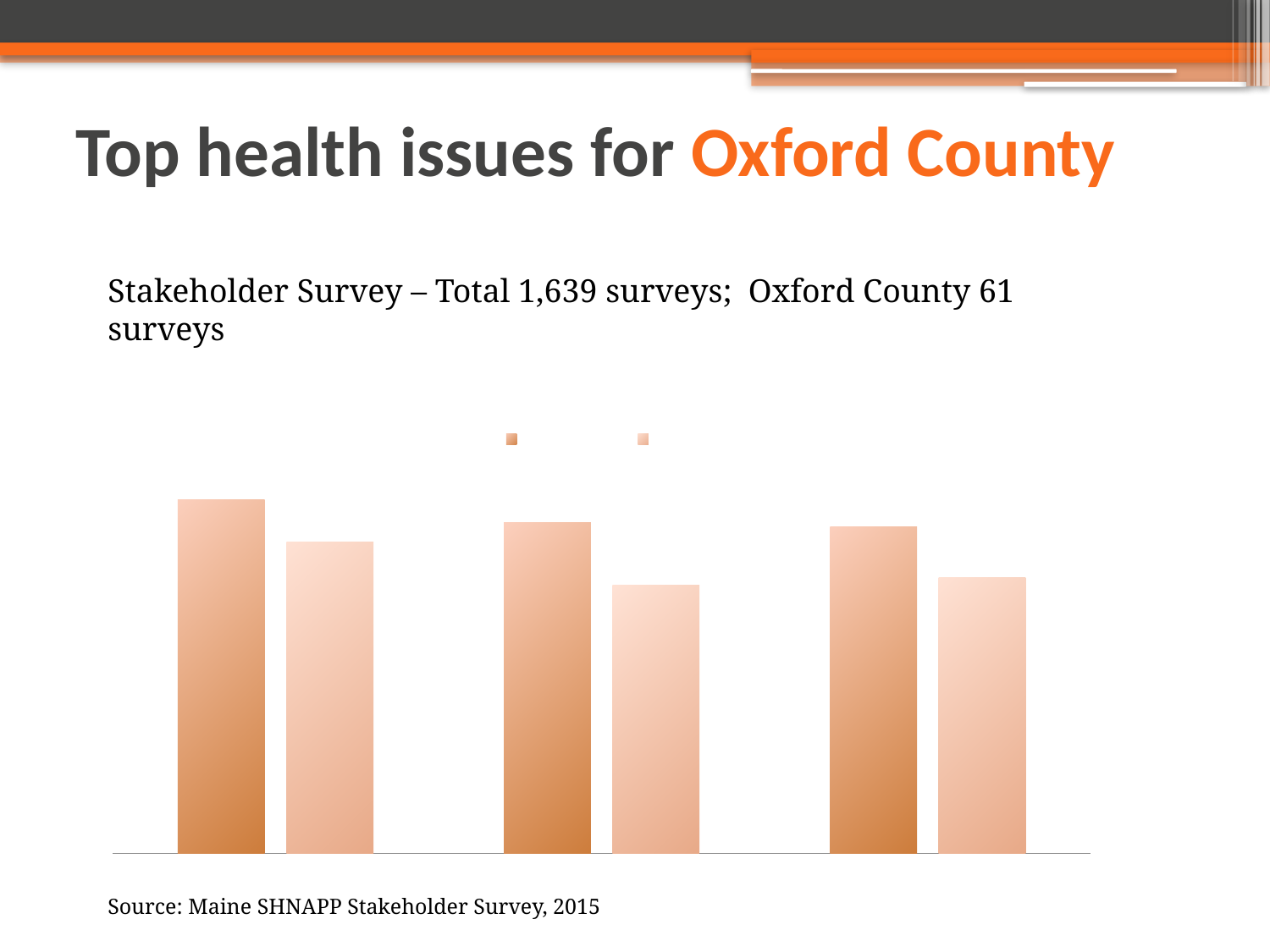
How many groups of bars does the chart show? 3 Which group of bars has the tallest darker bar: the leftmost, middle, or rightmost? leftmost Are the bars on the chart vertical or horizontal? vertical Which group of bars has the shortest lighter bar: the leftmost, middle, or rightmost? middle What colour are the bars on the chart? orange In the leftmost group of bars, is the darker bar taller or shorter than the lighter bar? taller What kind of chart is shown on the slide? bar chart How many series does the chart's legend show? 2 How many bars are plotted in total on the chart? 6 In the rightmost group of bars, is the darker bar taller or shorter than the lighter bar? taller In the middle group of bars, is the darker bar taller or shorter than the lighter bar? taller